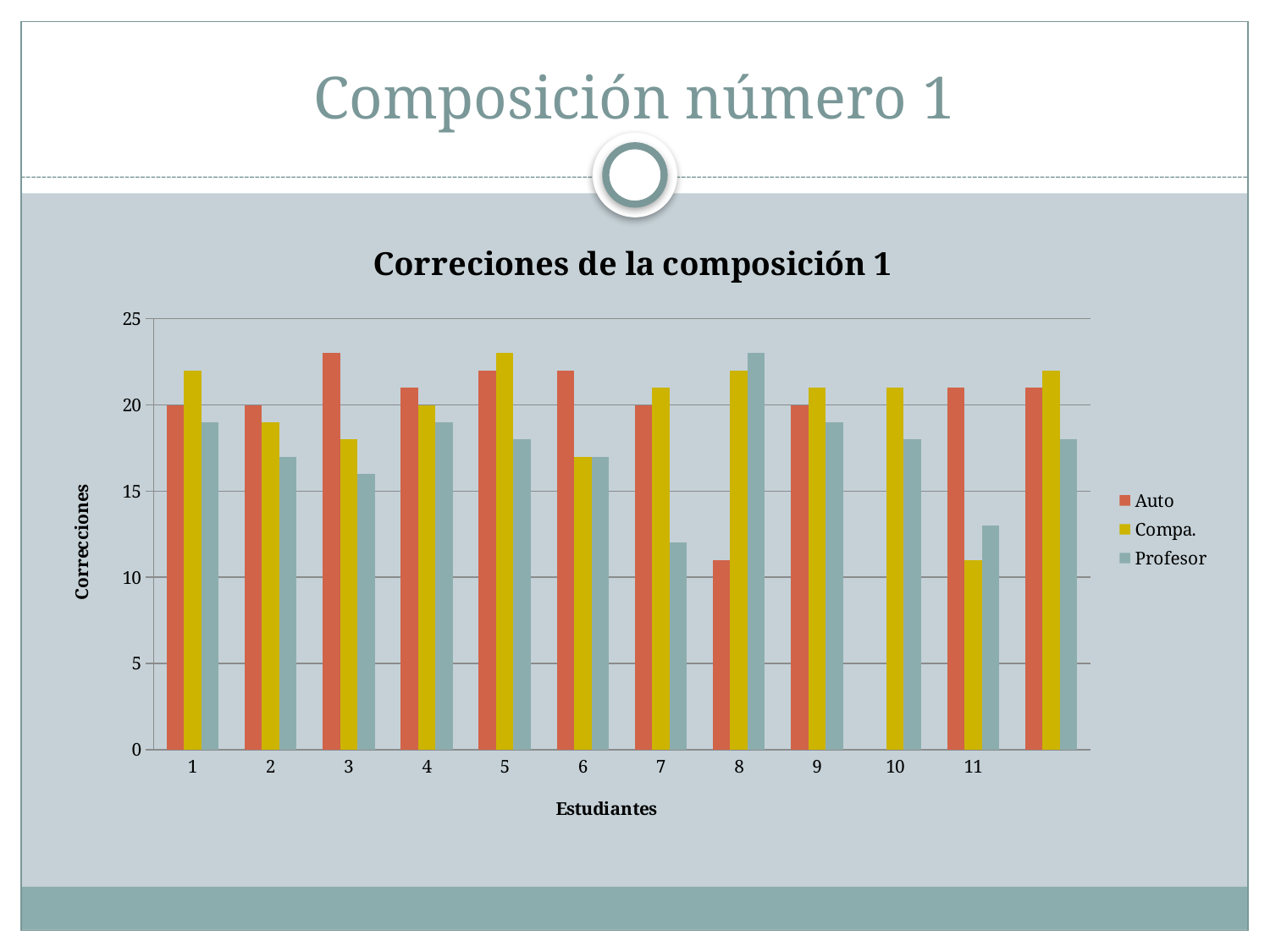
How many series does the legend list? 3 For student 8, which is larger, the Auto value or the Profesor value? Profesor Is the Profesor value for student 8 greater or less than 20? greater For student 3, which is larger, the Auto value or the Profesor value? Auto Is the Auto value for student 3 greater or less than 20? greater Is the Profesor value for student 7 greater or less than 15? less What are the series names listed in the legend? Auto, Compa., Profesor Which student has the lowest Auto value? 8 What kind of chart is shown on the slide? bar chart What is the title of the chart? Correciones de la composición 1